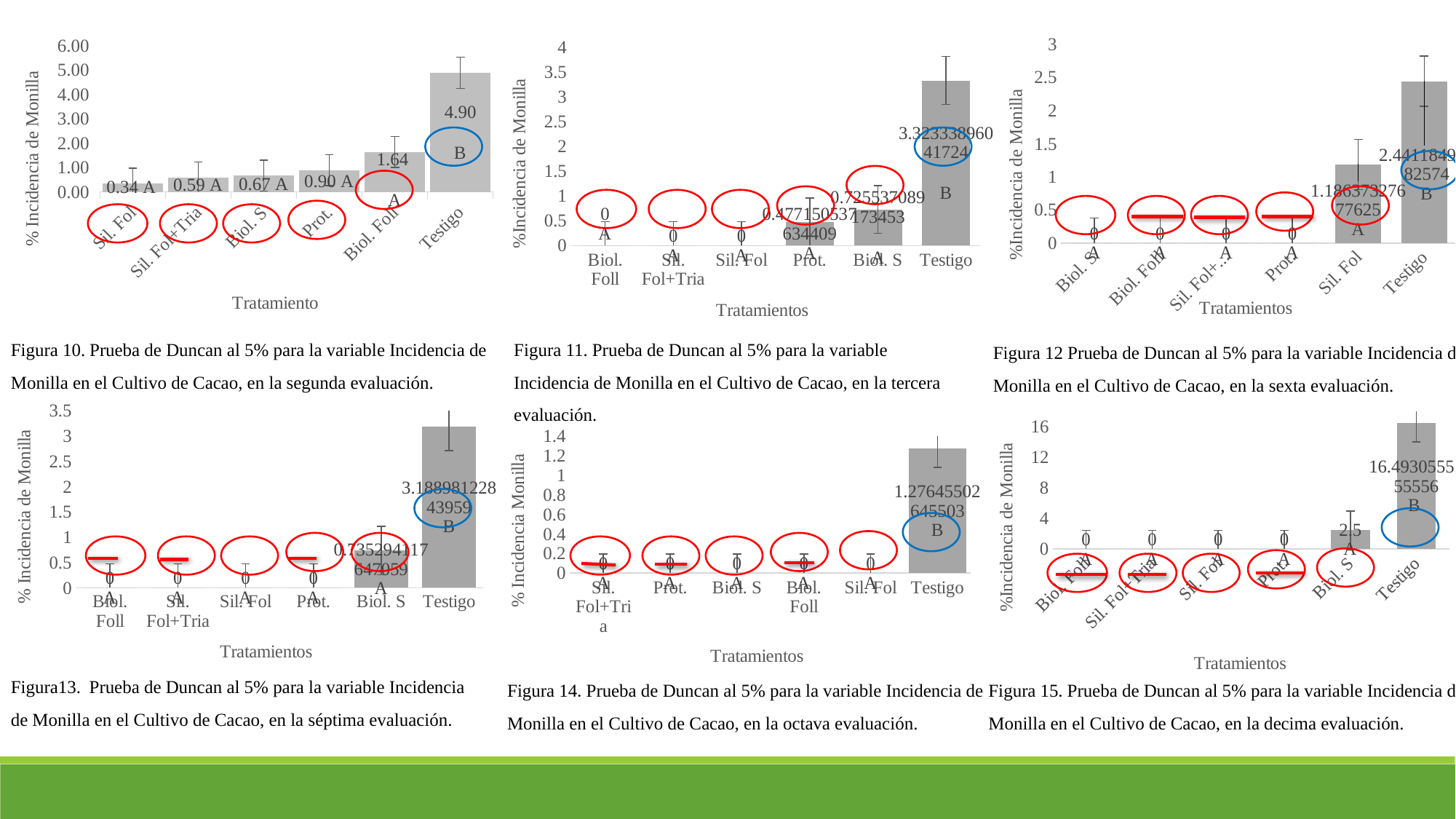
In the Figura 10 chart (segunda evaluación), what is the value for Sil. Fol? 0.34 In the Figura 10 chart (segunda evaluación), what is the difference between the Testigo value and the Biol. Foll value? 3.26 In the Figura 10 chart (segunda evaluación), what is the value for Testigo? 4.90 What kind of chart is the Figura 15 chart (decima evaluación)? bar chart In the Figura 10 chart (segunda evaluación), which treatment has the lowest incidence? Sil. Fol In the Figura 10 chart (segunda evaluación), do the values rise or fall from left to right along the x axis? rise In the Figura 15 chart (decima evaluación), what is the value for Biol. S? 2.5 In the Figura 12 chart (sexta evaluación), is the value for Testigo greater or less than 2? greater In the Figura 14 chart (octava evaluación), what is the value for Testigo? 1.27645502645503 In the Figura 10 chart (segunda evaluación), which treatment has the highest incidence? Testigo In the Figura 10 chart (segunda evaluación), how many treatments are shown on the x axis? 6 In the Figura 11 chart (tercera evaluación), which is larger, the value for Biol. S or the value for Prot.? Biol. S